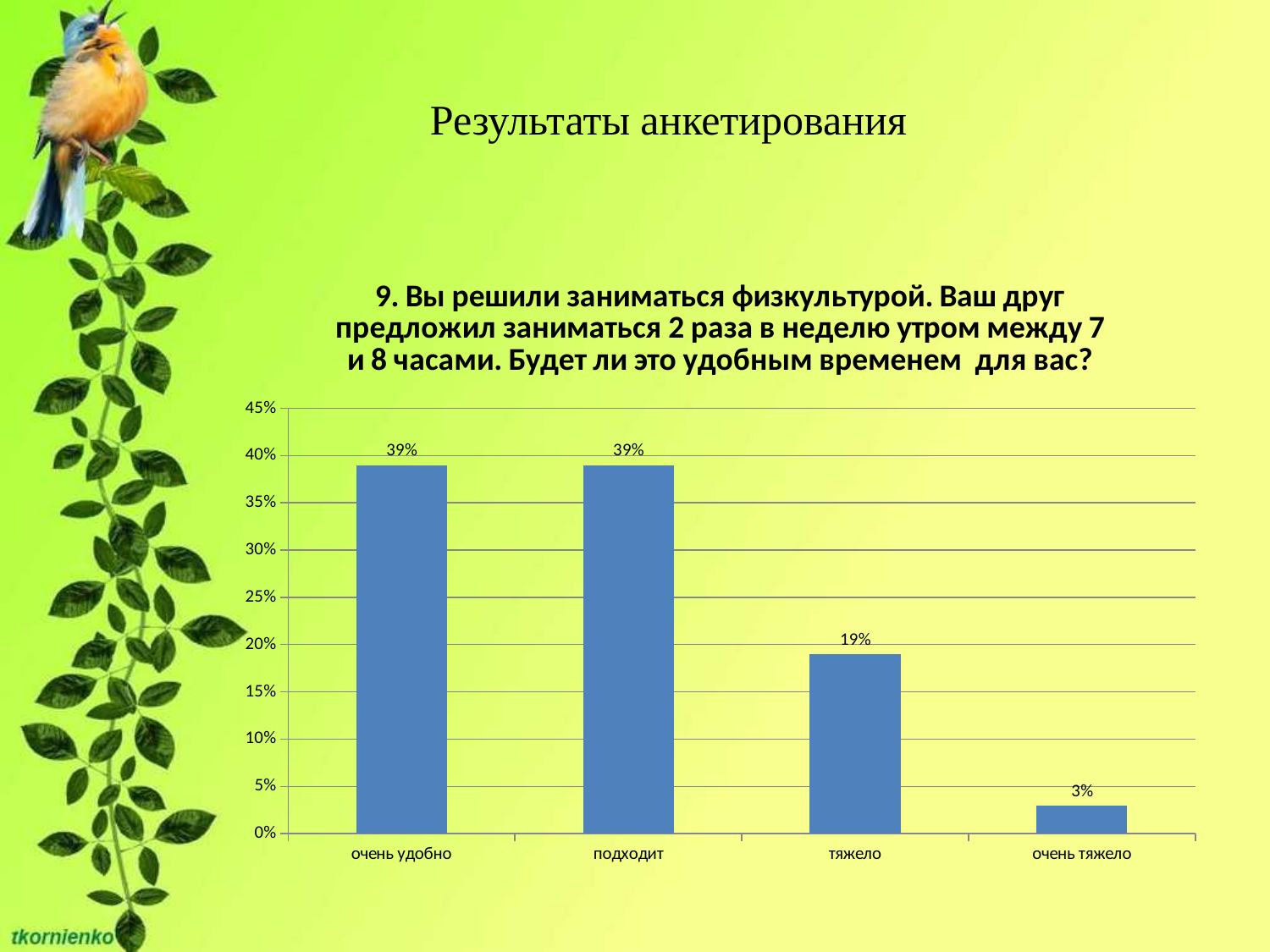
Which category has the lowest value? очень тяжело What is the value for "очень удобно"? 39% Is the value for "тяжело" greater or less than 20%? less What is the difference between the values for "тяжело" and "очень тяжело"? 16% How many categories are shown on the x axis? 4 What is the value for "тяжело"? 19% What is the difference between the values for "подходит" and "тяжело"? 20% Do the values rise or fall from left to right along the x axis? fall What is the value for "очень тяжело"? 3% What is the value for "подходит"? 39% What kind of chart is shown on the slide? bar chart Which is larger, the value for "очень удобно" or the value for "тяжело"? очень удобно